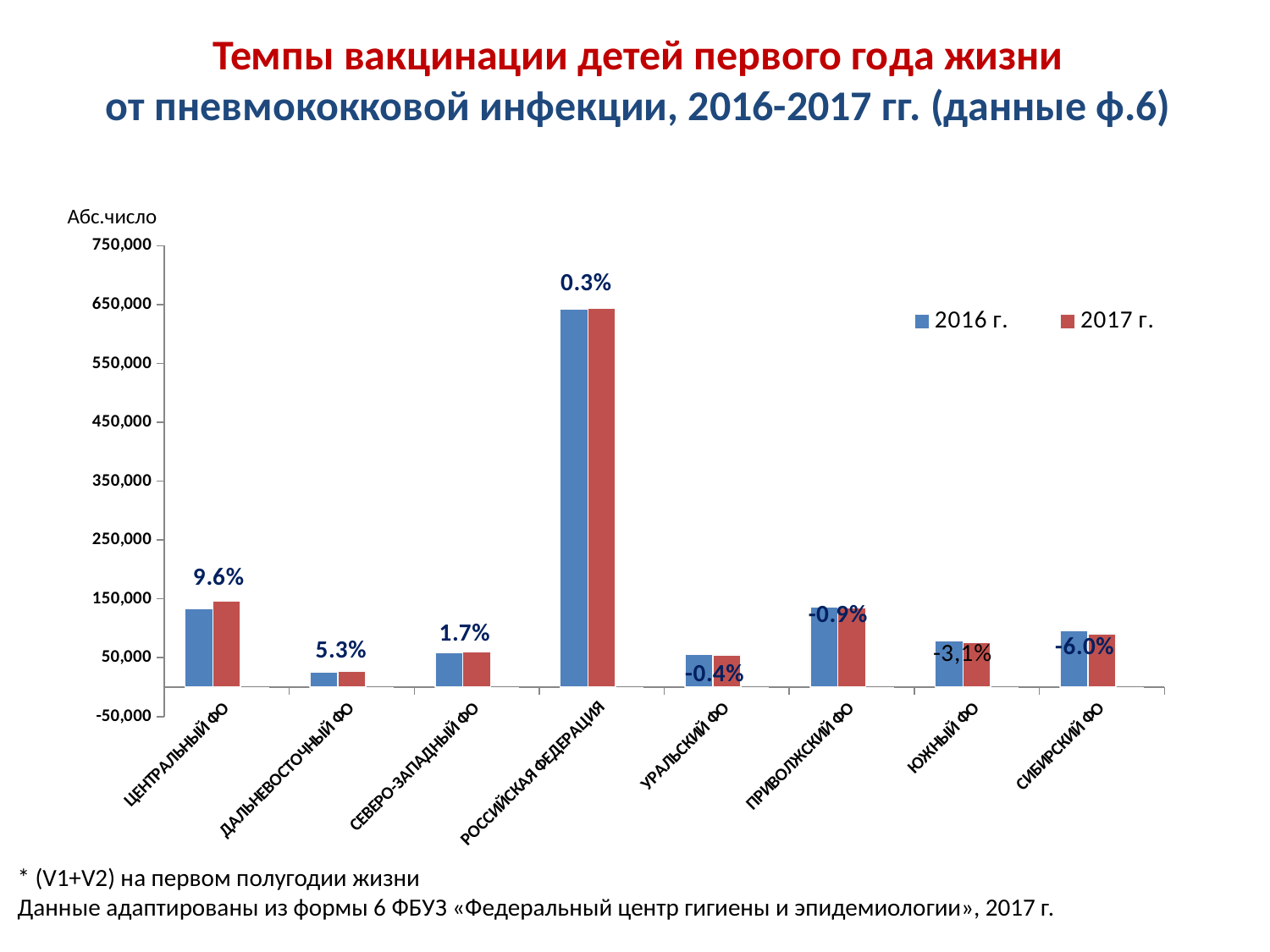
What percentage change is printed above the bars for Российская Федерация? 0.3% What percentage change is printed above the bars for Сибирский ФО? -6.0% What kind of chart is shown on the slide? bar chart Which category has the lowest bars? Дальневосточный ФО Which category has the highest bars? Российская Федерация What percentage change is printed above the bars for Центральный ФО? 9.6% Which is larger, the 2016 г. value for Центральный ФО or the 2016 г. value for Сибирский ФО? Центральный ФО How many categories are shown along the x axis? 8 Is the 2016 г. value for Дальневосточный ФО greater or less than 50,000? less Is the 2017 г. value for Российская Федерация greater or less than 550,000? greater What percentage change is printed above the bars for Дальневосточный ФО? 5.3% How many series does the legend list? 2